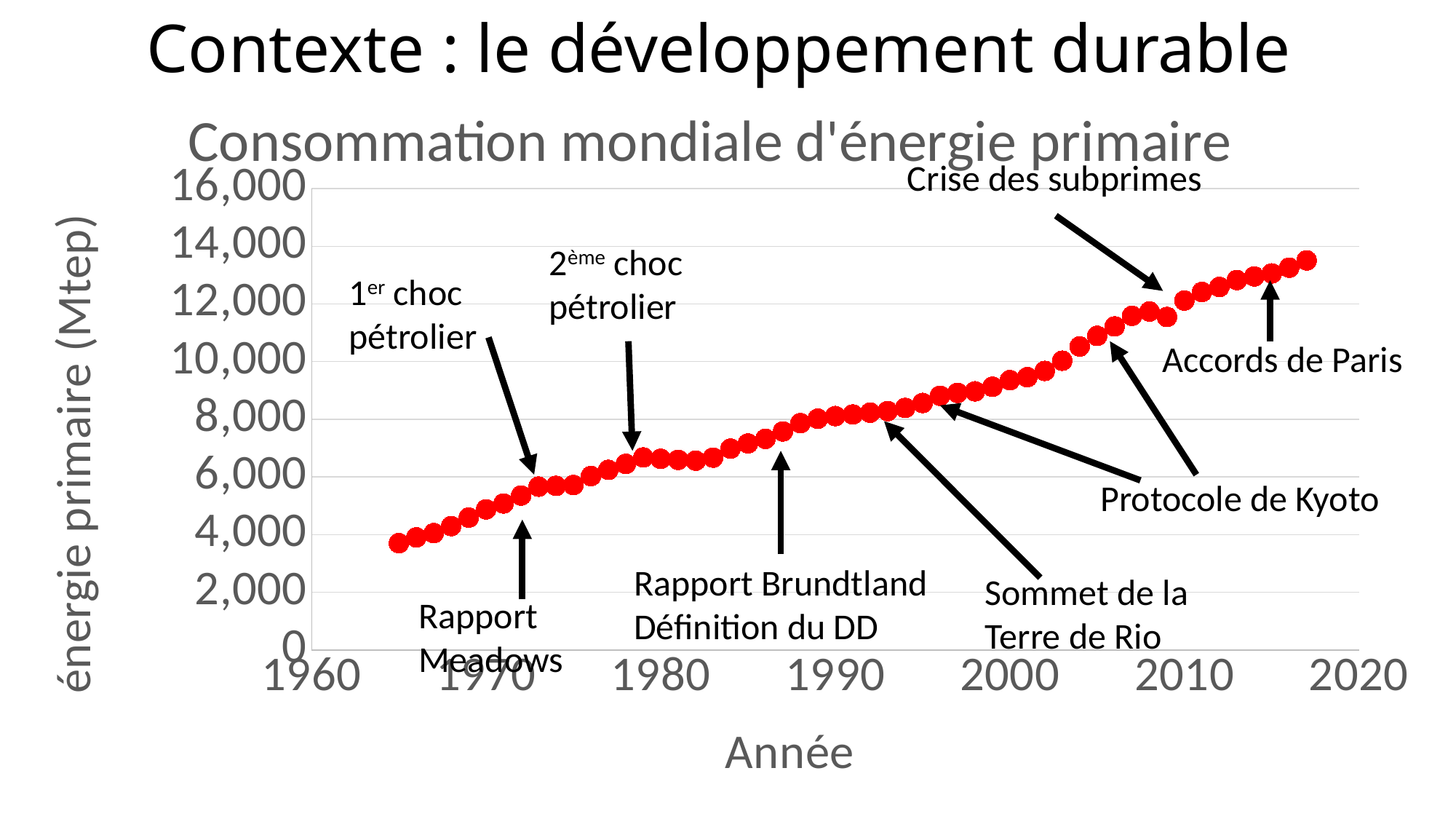
What kind of chart is shown on the slide? scatter chart Which year has the larger value, 1975 or 1985? 1985 Is the value for the last plotted year greater or less than 12,000? greater What is the title of the chart? Consommation mondiale d'énergie primaire Is the value for 1980 greater or less than 8,000? less Is the value for 1970 greater or less than 6,000? less What is the highest value shown on the y axis? 16,000 Which year has the larger value, 1990 or 2010? 2010 Do the values rise or fall as the year increases along the x axis? rise What is the label of the y axis? énergie primaire (Mtep)